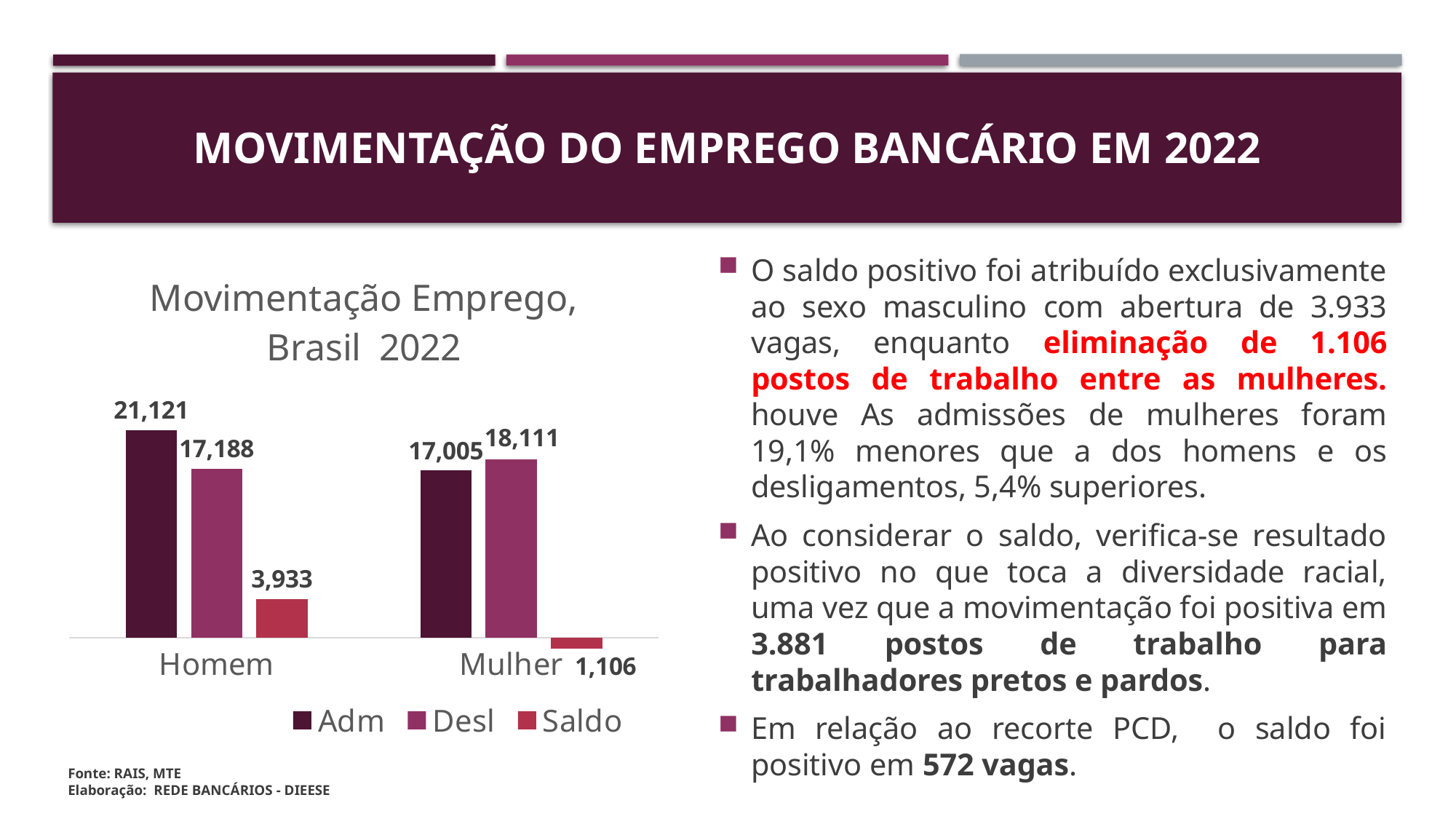
What is the Adm value for Mulher? 17,005 What is the Adm value for Homem? 21,121 How many categories are shown on the x axis of the chart? 2 What is the difference between the Adm values for Homem and Mulher? 4,116 What is the difference between the Desl values for Mulher and Homem? 923 What is the Desl value for Mulher? 18,111 What is the title of the chart? Movimentação Emprego, Brasil 2022 What kind of chart is shown on the slide? Bar chart How many series does the chart legend list? 3 Which category has the higher Desl value, Homem or Mulher? Mulher What is the Saldo value for Homem? 3,933 Which category has the higher Adm value, Homem or Mulher? Homem